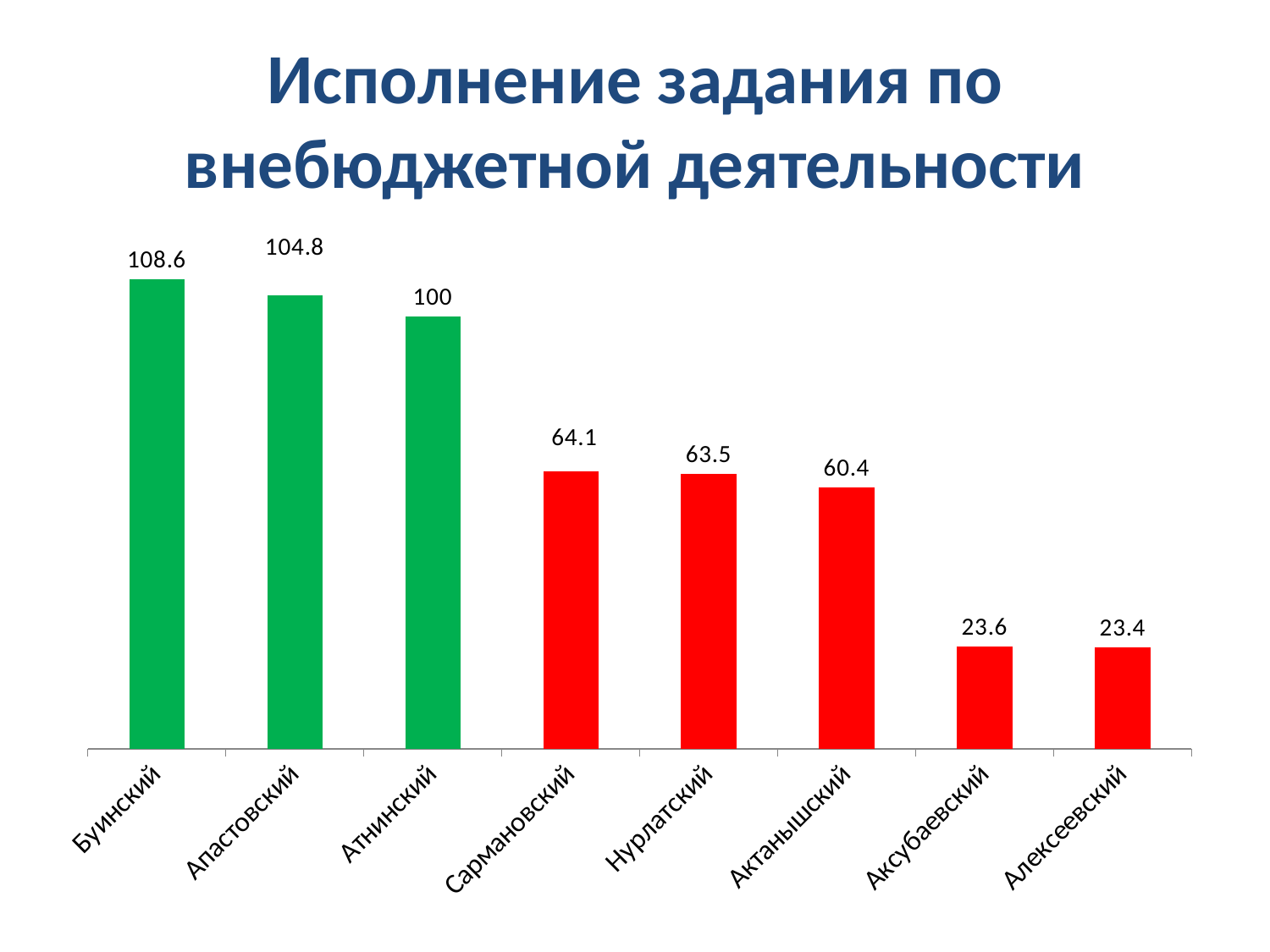
How many bars are coloured green? 3 How many categories are shown in the chart? 8 Which category has the highest value? Буинский What is the value for Сармановский? 64.1 Do the values rise or fall from left to right along the x axis? fall Which category has the lowest value? Алексеевский What is the difference between the values for Сармановский and Актанышский? 3.7 What is the difference between the values for Буинский and Атнинский? 8.6 What is the value for Буинский? 108.6 Which is larger, the value for Апастовский or the value for Нурлатский? Апастовский What is the value for Алексеевский? 23.4 What kind of chart is shown on the slide? bar chart